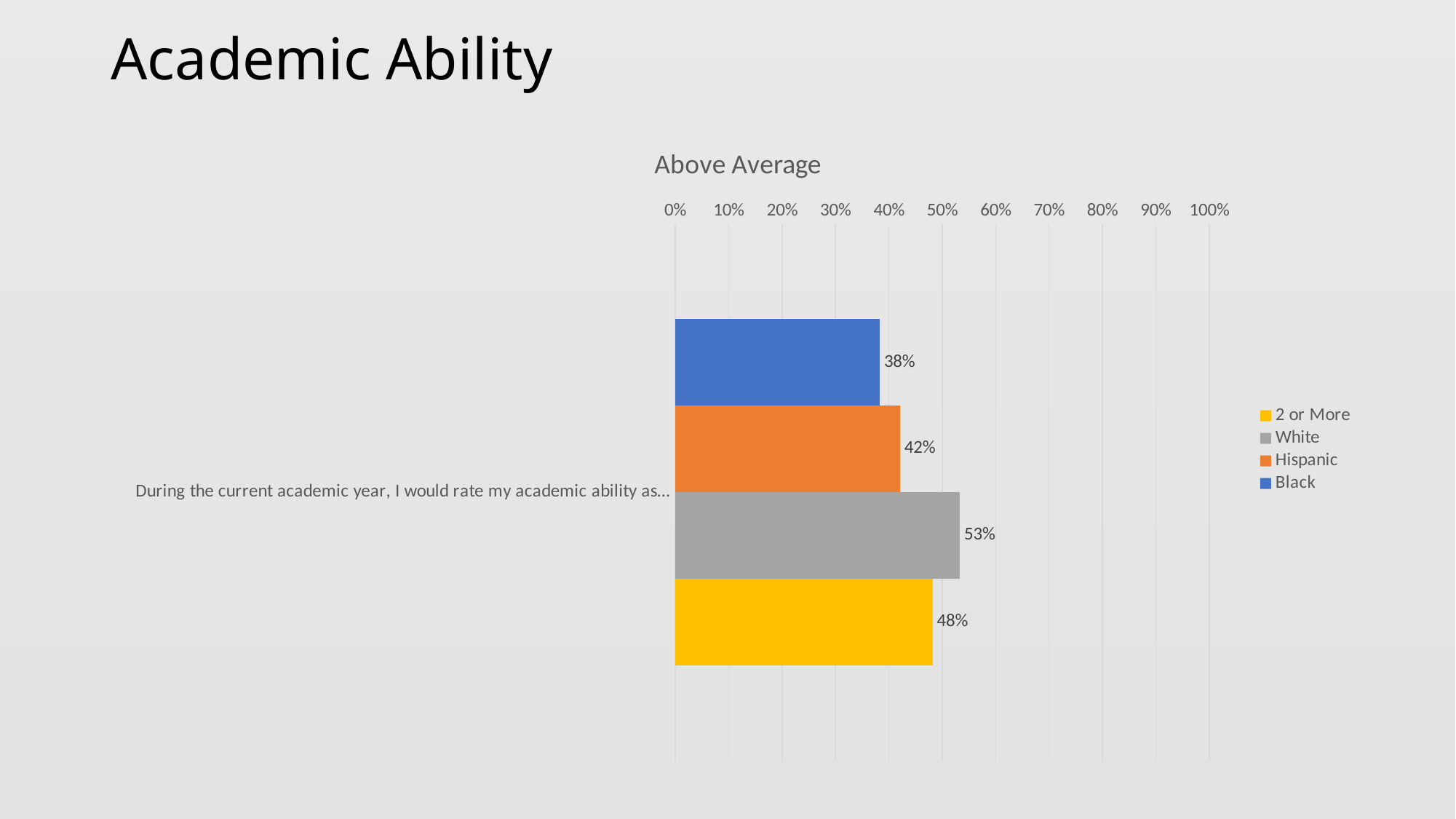
What is the difference between the 2 or More and Hispanic values in the Above Average chart? 6% What is the value for 2 or More in the Above Average chart? 48% What is the value for White in the Above Average chart? 53% Which series has the lowest value in the Above Average chart? Black Which is larger in the Above Average chart, the value for 2 or More or the value for White? White What is the value for Black in the Above Average chart? 38% What colour is the bar for Hispanic in the Above Average chart? Orange What kind of chart is shown on the slide? Bar chart How many series does the legend list in the Above Average chart? 4 Which series has the highest value in the Above Average chart? White What is the value for Hispanic in the Above Average chart? 42% What is the difference between the White and Black values in the Above Average chart? 15%